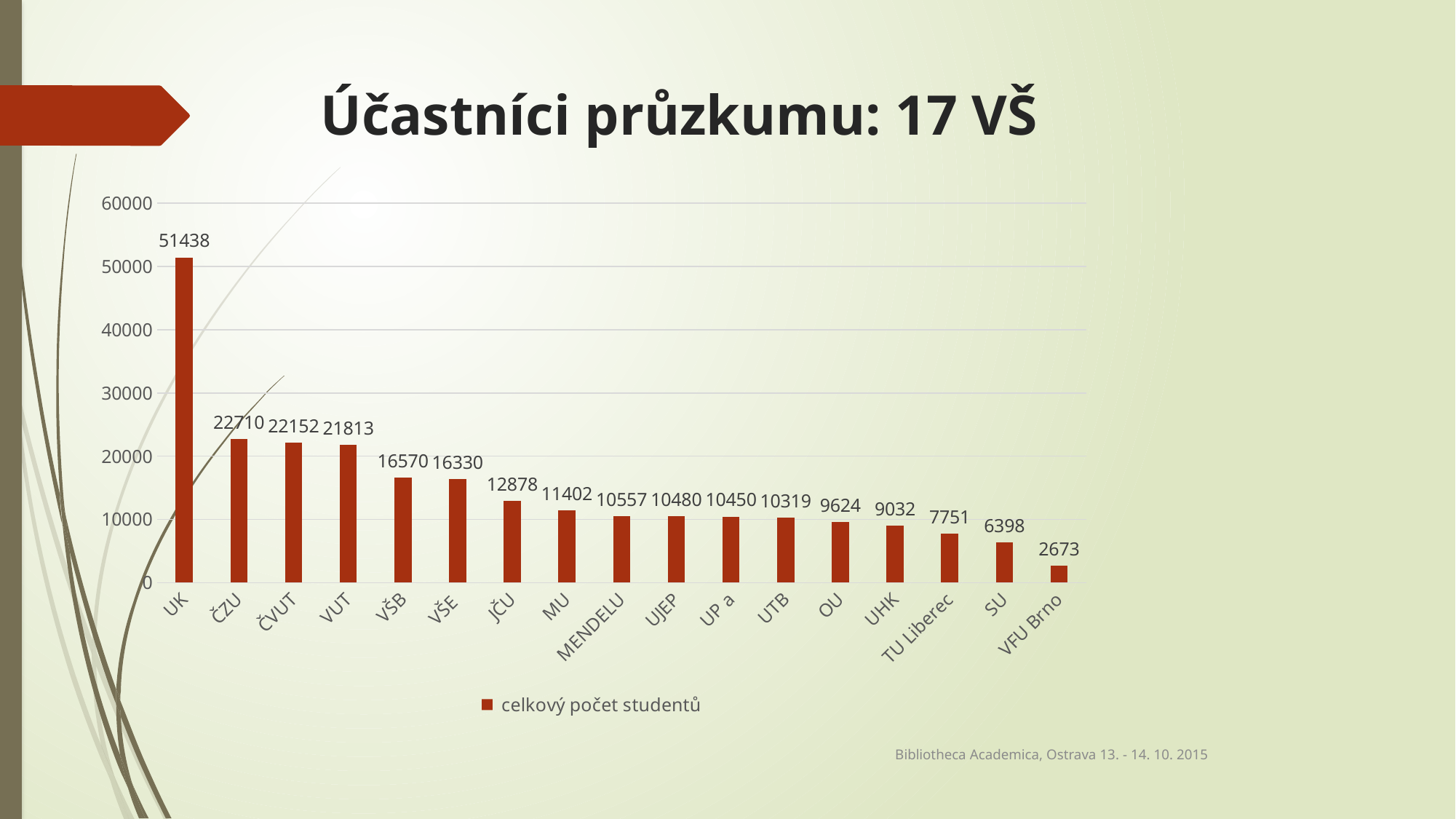
Which is larger, the value for JČU or the value for MU? JČU Which category has the highest value? UK What is the value for MENDELU? 10557 What is the difference between the values for ČZU and ČVUT? 558 What kind of chart is shown on the slide? bar chart Which category has the lowest value? VFU Brno What is the difference between the values for UK and VFU Brno? 48765 What is the value for VŠB? 16570 How many categories are shown on the x axis? 17 What is the value for TU Liberec? 7751 What is the value for UK? 51438 What is the legend entry for the series shown? celkový počet studentů